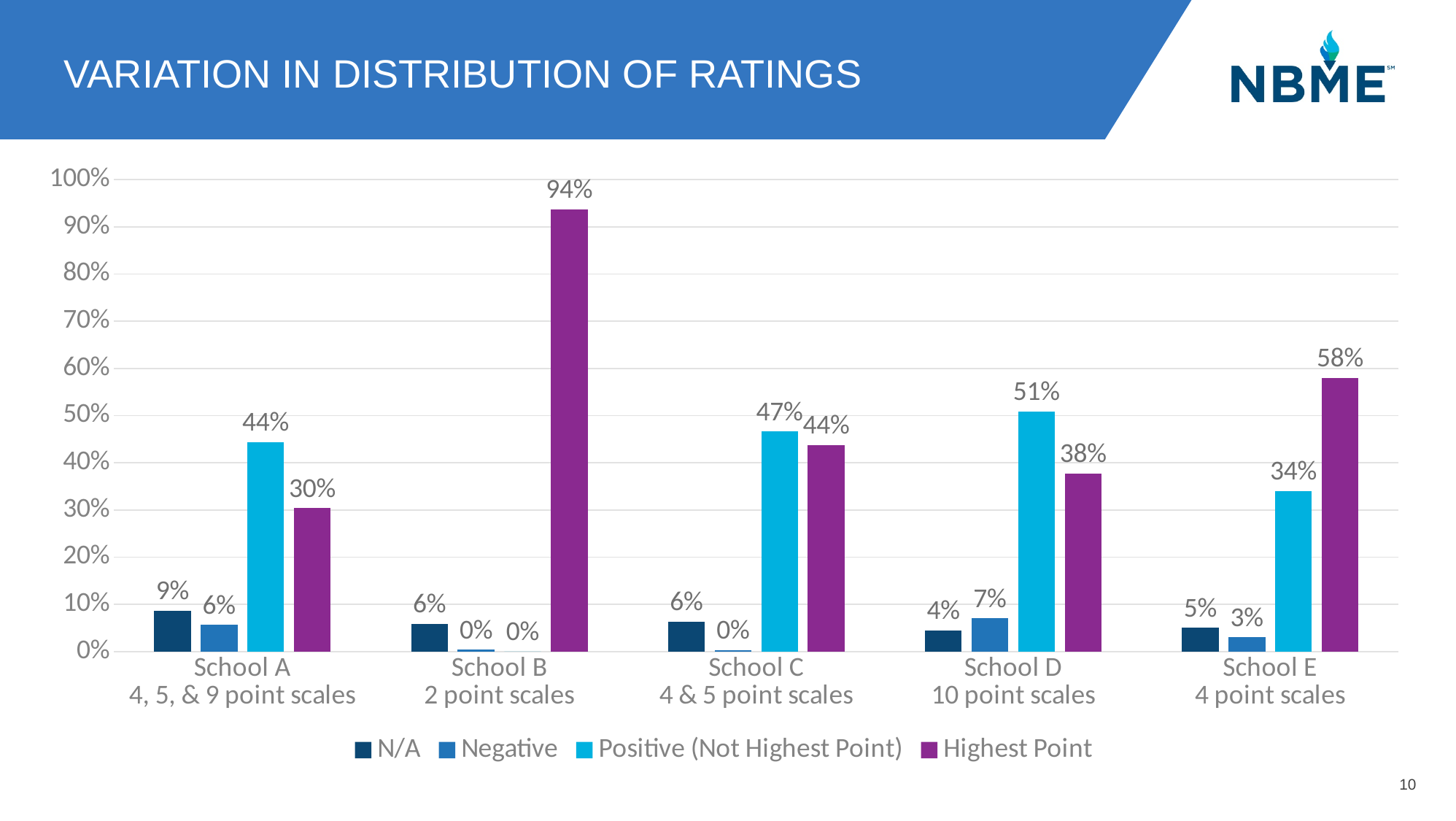
What is the Highest Point value for School B? 94% What is the Negative value for School E? 3% What rating scales are listed under School A? 4, 5, & 9 point scales What kind of chart is shown on the slide? Bar chart How many series does the legend list? 4 How many schools are shown on the x axis? 5 Which school has the lowest N/A value? School D Which school has the highest Highest Point value? School B For School C, which is larger: Positive (Not Highest Point) or Highest Point? Positive (Not Highest Point) What is the N/A value for School A? 9% What is the Positive (Not Highest Point) value for School D? 51% What is the difference between the Highest Point values for School E and School A? 28%